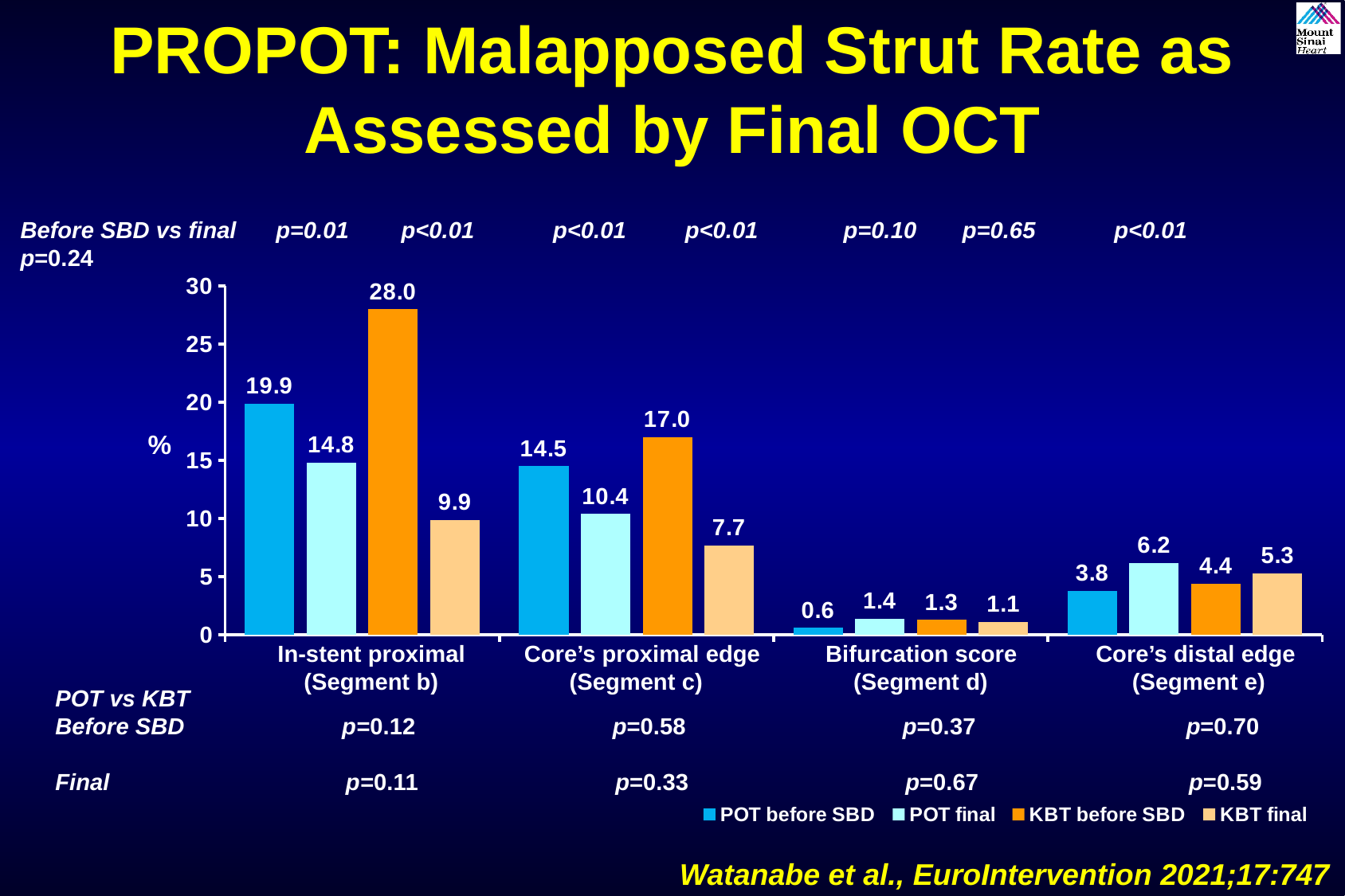
What is the value for KBT final in the Core's distal edge (Segment e) category? 5.3 How many categories are shown on the x axis? 4 Which category has the highest value for KBT before SBD? In-stent proximal (Segment b) Which category has the lowest value for POT final? Bifurcation score (Segment d) What is the value for POT final in the Core's proximal edge (Segment c) category? 10.4 How many series does the legend list? 4 Which is larger in the Core's distal edge (Segment e) category: POT final or KBT final? POT final What is the label on the y axis? % What is the value for POT before SBD in the Bifurcation score (Segment d) category? 0.6 What is the value for KBT before SBD in the In-stent proximal (Segment b) category? 28.0 What kind of chart is shown on the slide? Bar chart What is the difference between POT before SBD and POT final in the In-stent proximal (Segment b) category? 5.1